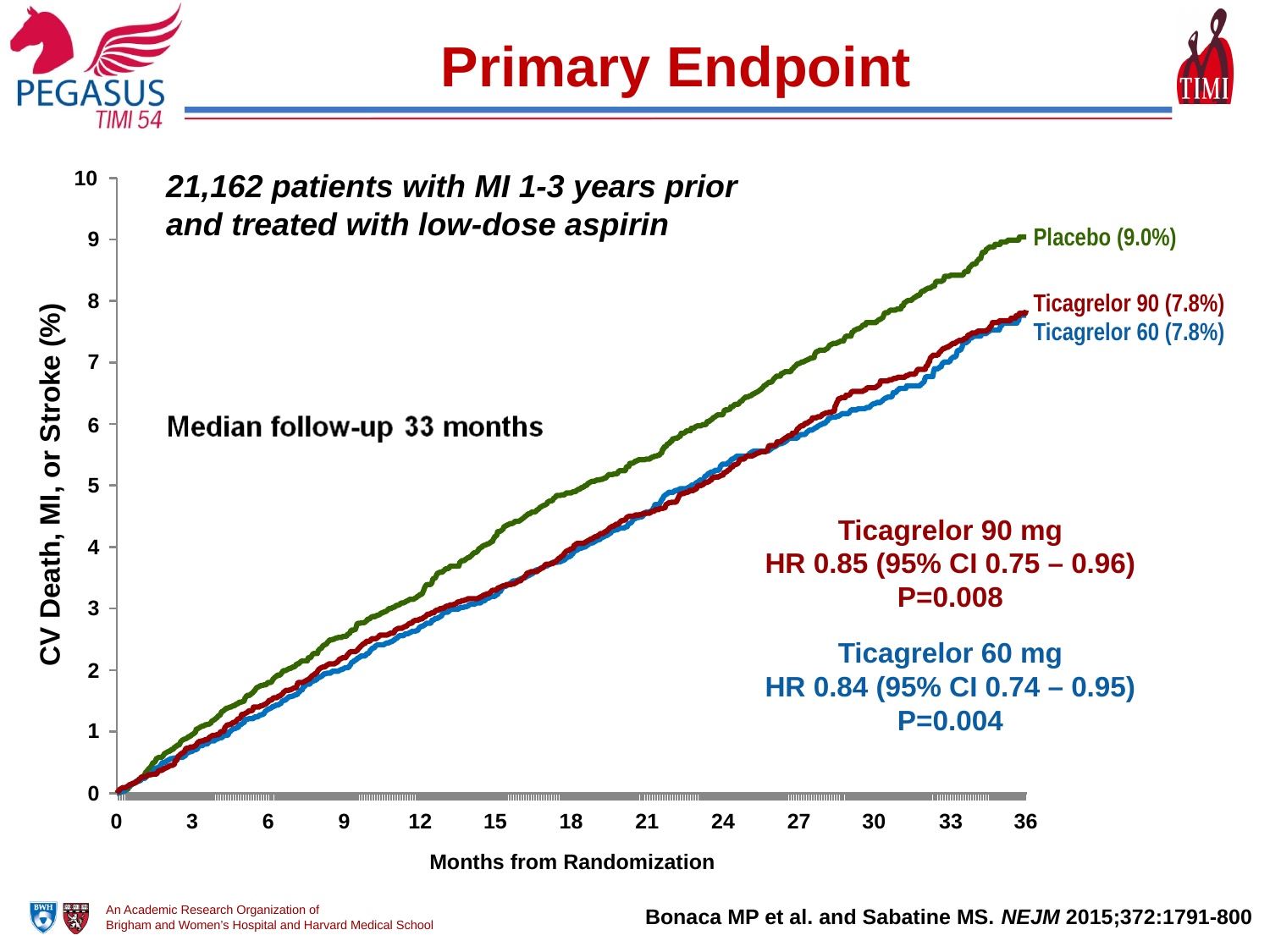
What is the event rate shown for the Ticagrelor 90 group at the end of follow-up? 7.8% Which is larger at the end of follow-up, the Placebo event rate or the Ticagrelor 60 event rate? Placebo Which group has the highest event rate at the end of follow-up? Placebo Is the Placebo curve at 36 months greater or less than 8%? greater What is the difference between the Placebo event rate and the Ticagrelor 90 event rate at the end of follow-up? 1.2% What kind of chart is shown on the slide? line chart Is the Placebo curve at 12 months greater or less than 4%? less How many treatment groups (series) are plotted on the chart? 3 What is the event rate shown for the Placebo group at the end of follow-up? 9.0% What is the event rate shown for the Ticagrelor 60 group at the end of follow-up? 7.8% Do the curves rise or fall as months from randomization increase? rise What is the label of the x axis? Months from Randomization